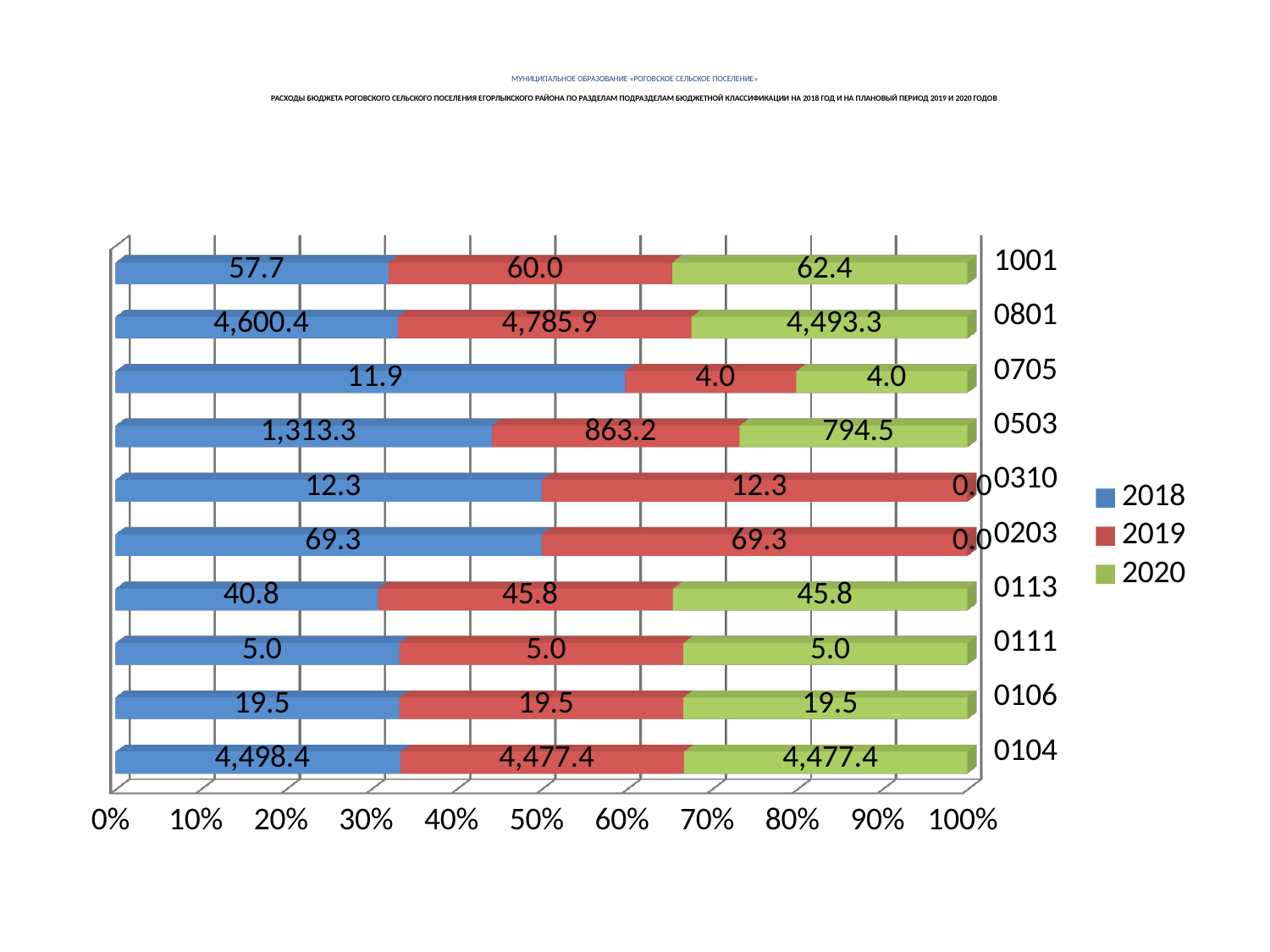
Which category has the lowest 2019 value? 0705 What is the 2018 value for category 0801? 4,600.4 What is the 2019 value for category 0503? 863.2 Which colour represents the 2020 series in the legend? Green Which is larger for category 0705: the 2018 value or the 2019 value? 2018 What is the difference between the 2019 and 2018 values for category 0113? 5.0 What is the 2020 value for category 0310? 0.0 What kind of chart is shown on the slide? Stacked bar chart What is the 2020 value for category 1001? 62.4 How many categories are shown on the chart? 10 Which category has the highest 2018 value? 0801 How many series does the legend list? 3